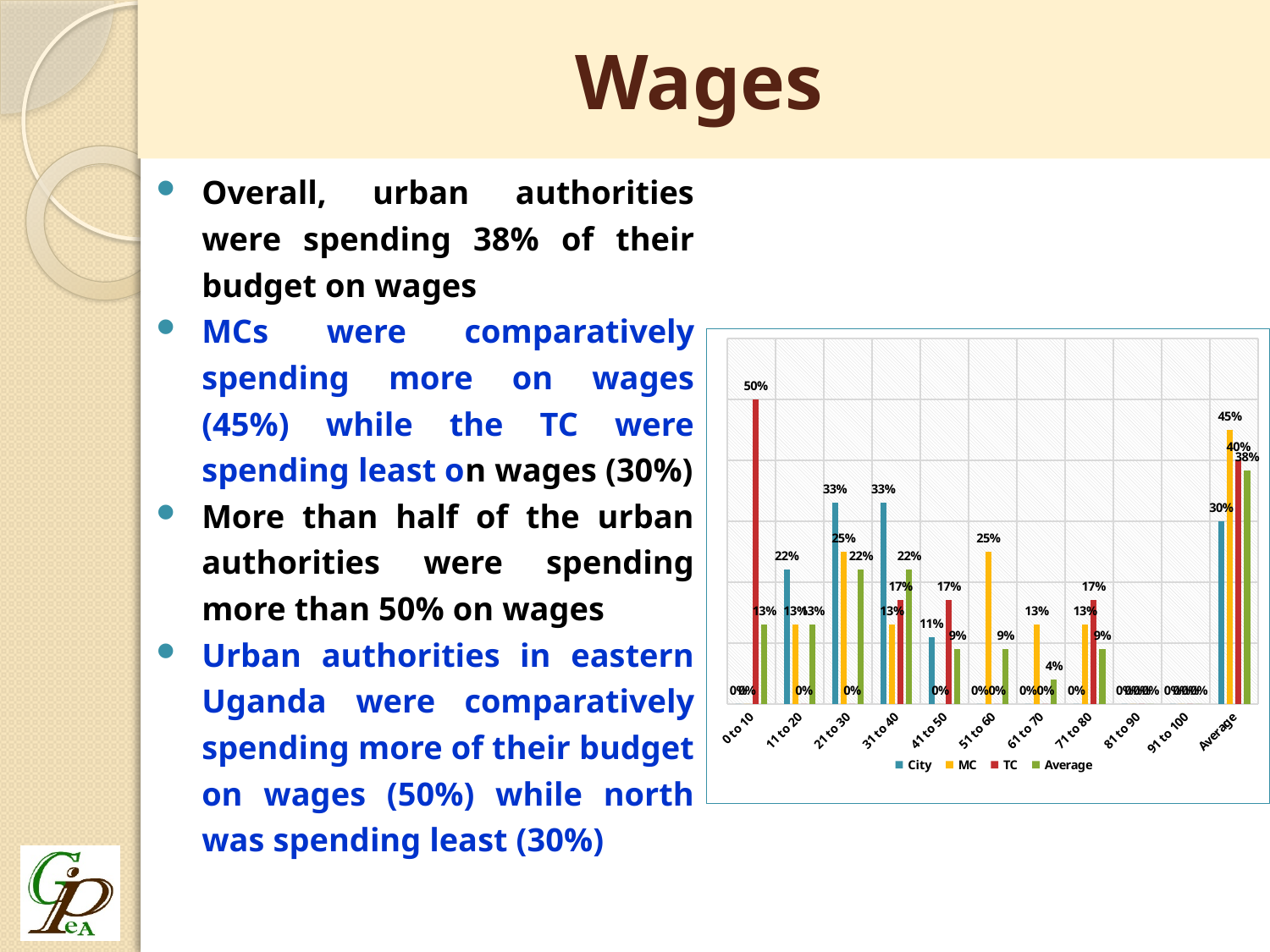
What kind of chart is shown on the slide? bar chart What is the TC value for the 0 to 10 category? 50% In the 21 to 30 category, which is larger: the City value or the MC value? City How many categories are shown along the x axis of the chart? 11 What is the MC value in the Average category? 45% What are the four entries listed in the chart legend? City, MC, TC, Average In the Average category, what is the difference between the MC value and the City value? 15% What is the Average series value for the 61 to 70 category? 4% In which category does the TC series reach its highest value? 0 to 10 How many series does the chart legend list? 4 In the Average category, which series has the highest value? MC What is the City value in the Average category? 30%